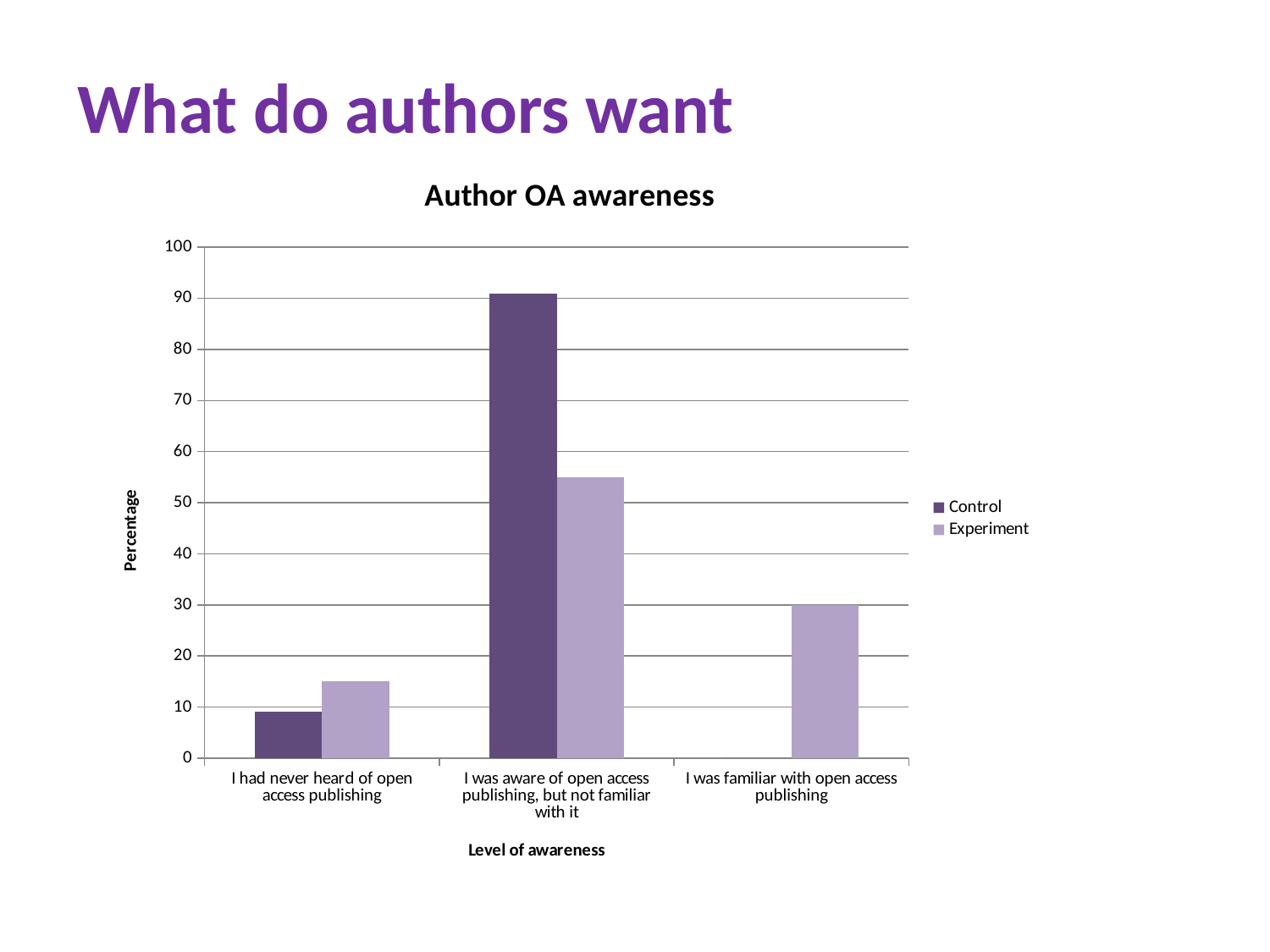
Which category has the highest Control value? I was aware of open access publishing, but not familiar with it What is the label of the vertical axis? Percentage What kind of chart is shown on the slide? bar chart For 'I had never heard of open access publishing', which series has the larger value, Control or Experiment? Experiment How many series does the legend list? 2 What is the title of the chart? Author OA awareness Which category has the highest Experiment value? I was aware of open access publishing, but not familiar with it Is the Control value for 'I was aware of open access publishing, but not familiar with it' greater or less than 80? greater Is the Control value for 'I had never heard of open access publishing' greater or less than 10? less How many categories are shown on the x axis? 3 Is the Experiment value for 'I was aware of open access publishing, but not familiar with it' greater or less than 50? greater For 'I was aware of open access publishing, but not familiar with it', which series has the larger value, Control or Experiment? Control